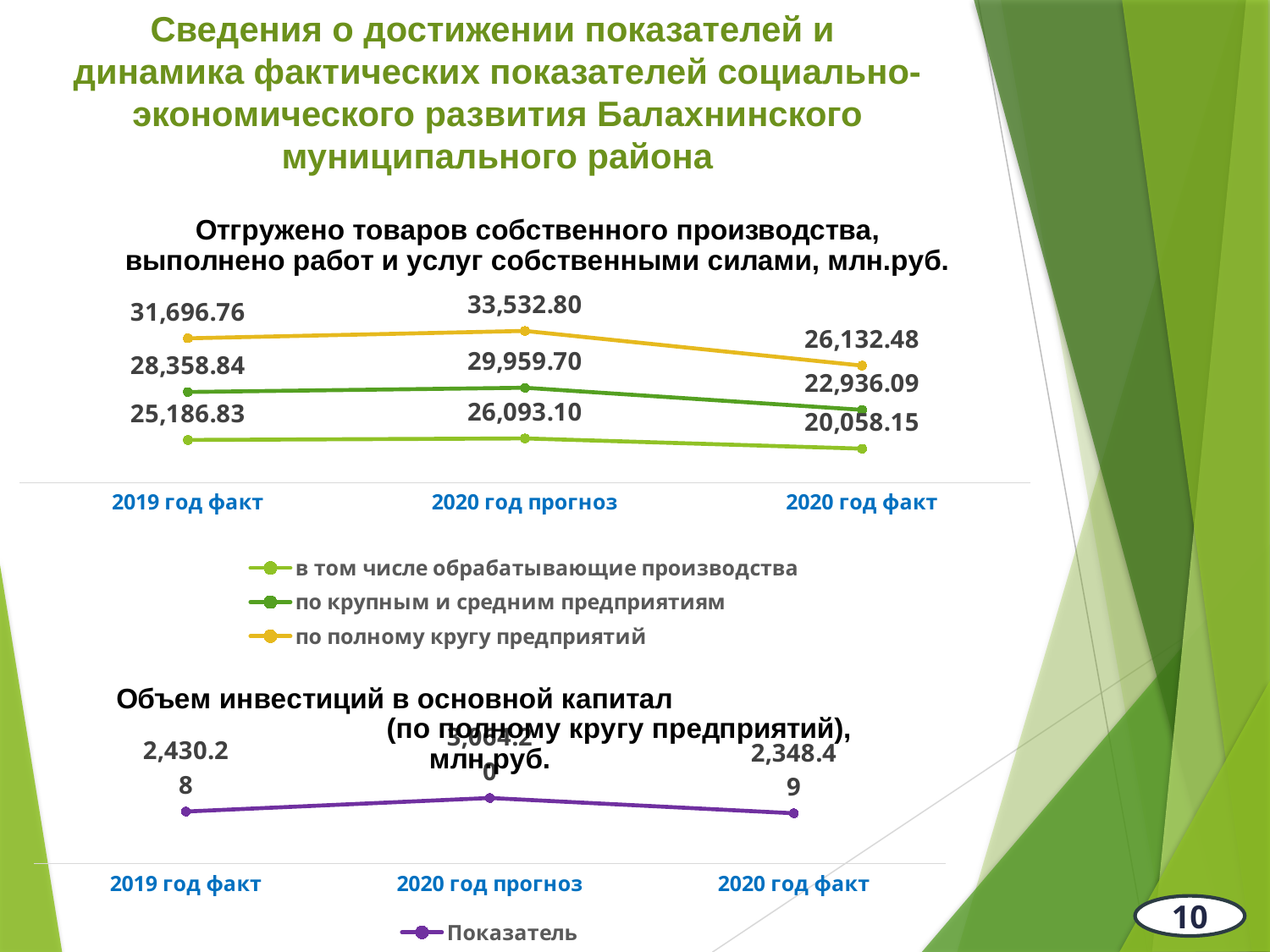
How many categories are shown on the x axis of the top chart? 3 How many series does the legend of the top chart list? 3 In the bottom chart 'Объем инвестиций в основной капитал', which is larger: the value for 2019 год факт or 2020 год факт? 2019 год факт In the bottom chart 'Объем инвестиций в основной капитал', what series name does the legend show? Показатель In the top chart, what is the value for 'по полному кругу предприятий' in 2020 год прогноз? 33,532.80 In the top chart, what is the value for 'в том числе обрабатывающие производства' in 2020 год факт? 20,058.15 What kind of chart is the top chart? Line chart In the top chart, which is larger for 2019 год факт: 'по крупным и средним предприятиям' or 'в том числе обрабатывающие производства'? по крупным и средним предприятиям In the top chart, what is the difference between the 2020 год прогноз and 2020 год факт values for 'по полному кругу предприятий'? 7,400.32 In the top chart, which category has the lowest value for 'по крупным и средним предприятиям'? 2020 год факт In the top chart, which category has the highest value for 'по полному кругу предприятий'? 2020 год прогноз In the top chart, what is the value for 'по крупным и средним предприятиям' in 2019 год факт? 28,358.84